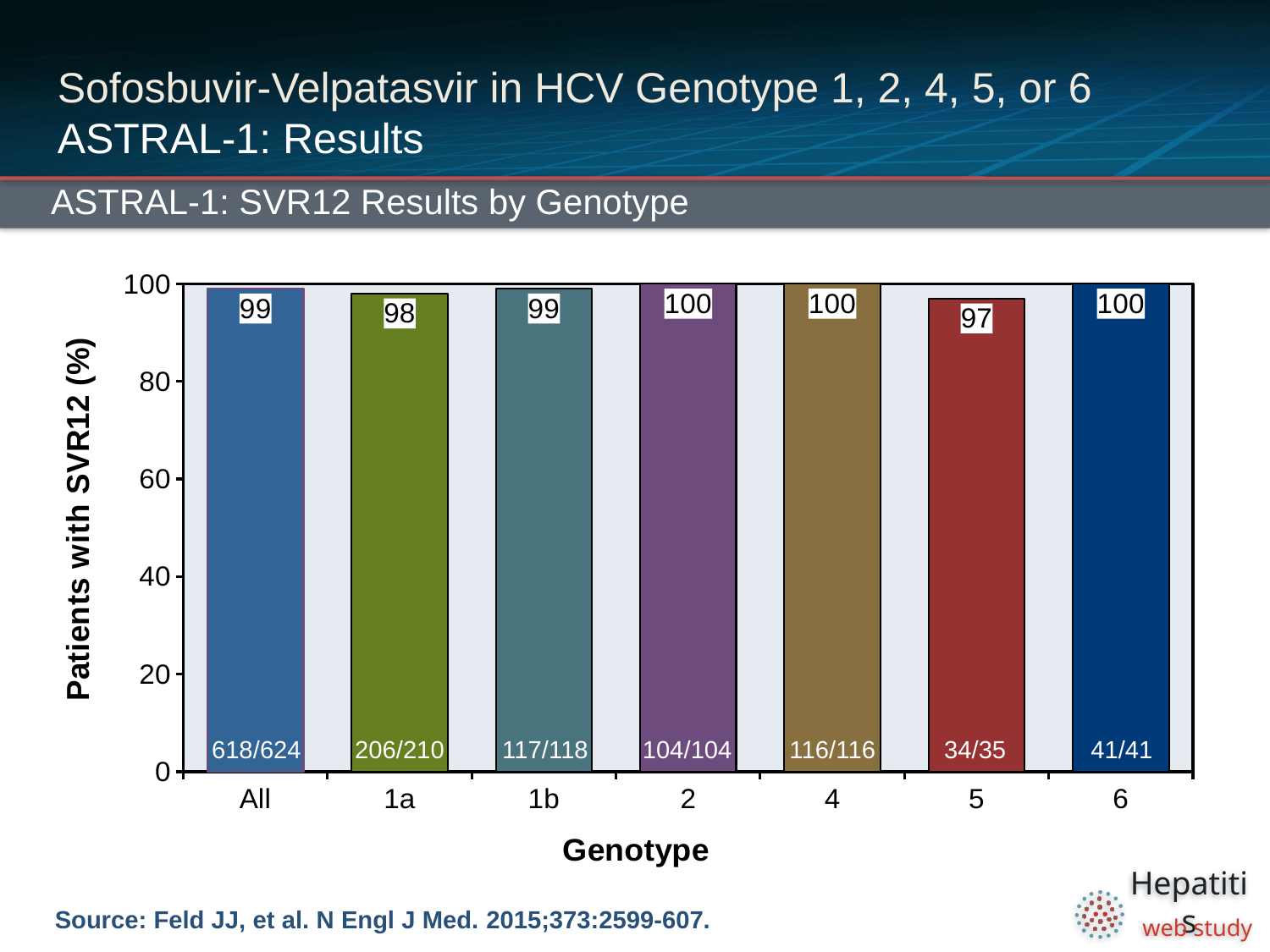
What is the difference in SVR12 rate between genotype 2 and genotype 5? 3 What kind of chart is shown? Bar chart What is the title of the chart? ASTRAL-1: SVR12 Results by Genotype What is the SVR12 rate for the All group? 99 Which has a higher SVR12 rate, genotype 1a or genotype 4? Genotype 4 Which genotype has the lowest SVR12 rate? 5 What is the SVR12 rate for genotype 1a? 98 What fraction of patients is shown for genotype 1b? 117/118 How many genotype categories are shown on the x axis? 7 What is the label of the y axis? Patients with SVR12 (%) What fraction of patients is shown for genotype 6? 41/41 What is the SVR12 rate for genotype 5? 97